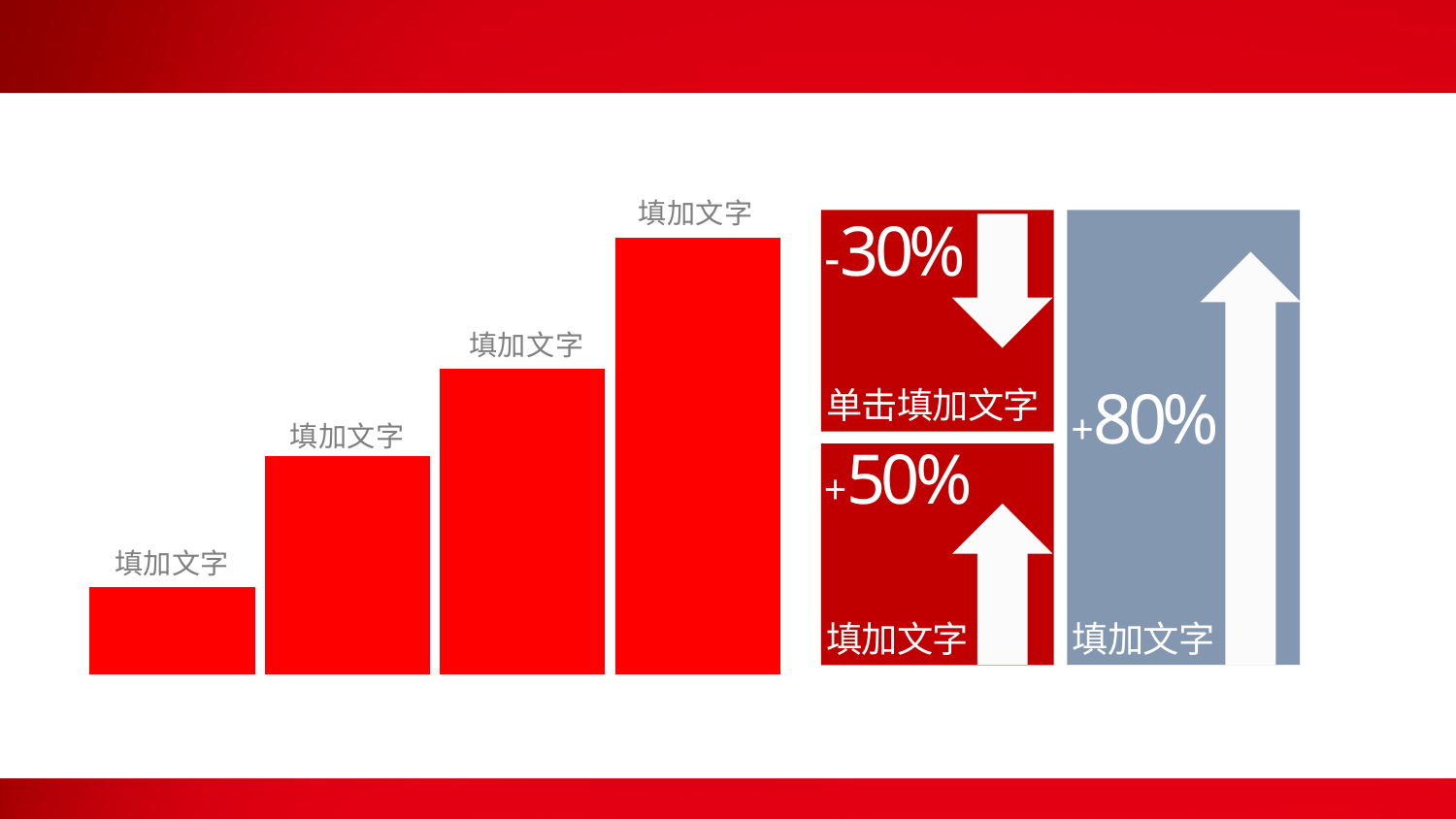
How many bars does the bar chart on the left contain? 4 What percentage is printed in the grey box with the upward arrow to the right of the bar chart? +80% What kind of chart is shown on the left side of the slide? bar chart In the chart on the left, is the second bar from the left taller or shorter than the third bar? shorter Which bar in the chart on the left is the tallest? the rightmost (fourth) bar What percentage is printed in the top red box with the downward arrow to the right of the bar chart? -30% Do the bars in the chart on the left rise or fall from left to right? rise In the chart on the left, is the fourth bar taller or shorter than the first bar? taller Which bar in the chart on the left is the shortest? the leftmost (first) bar